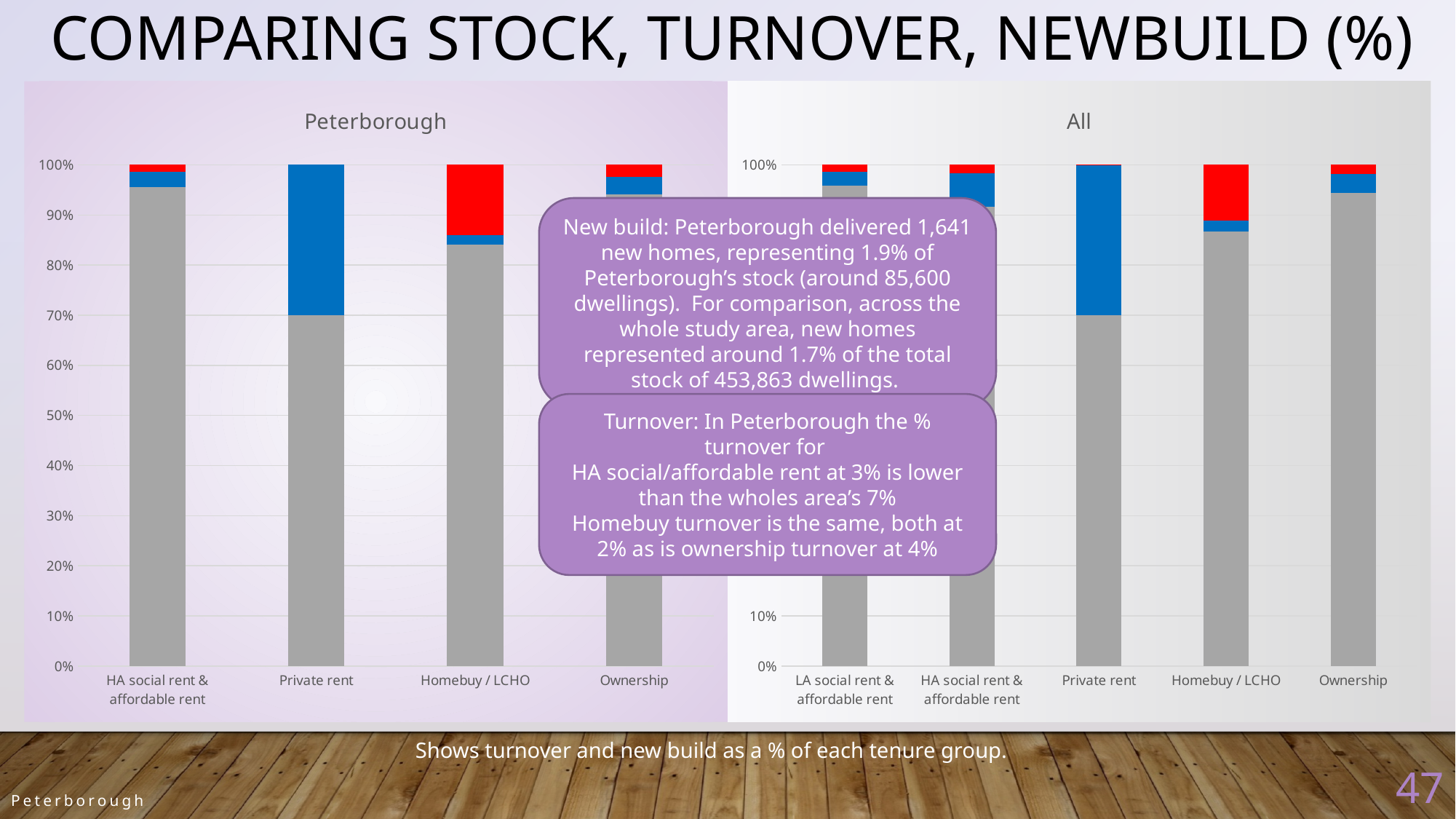
In the All chart, is the top of the grey segment for Private rent greater or less than 60%? greater What is the title of the chart on the right side of the slide? All In the Peterborough chart, is the top of the grey segment for Homebuy / LCHO greater or less than 90%? less In the Peterborough chart, which category has the smallest grey segment? Private rent How many tenure categories are shown on the x axis of the Peterborough chart? 4 In the Peterborough chart, which category has the largest red segment? Homebuy / LCHO In the All chart, which has the larger red segment, Homebuy / LCHO or Ownership? Homebuy / LCHO In the All chart, which category has the smallest grey segment? Private rent In the Peterborough chart, is the top of the grey segment for Private rent greater or less than 80%? less What kind of chart is the Peterborough chart on the left? Stacked bar chart How many tenure categories are shown on the x axis of the All chart? 5 In the Peterborough chart, which has the taller grey segment, HA social rent & affordable rent or Private rent? HA social rent & affordable rent